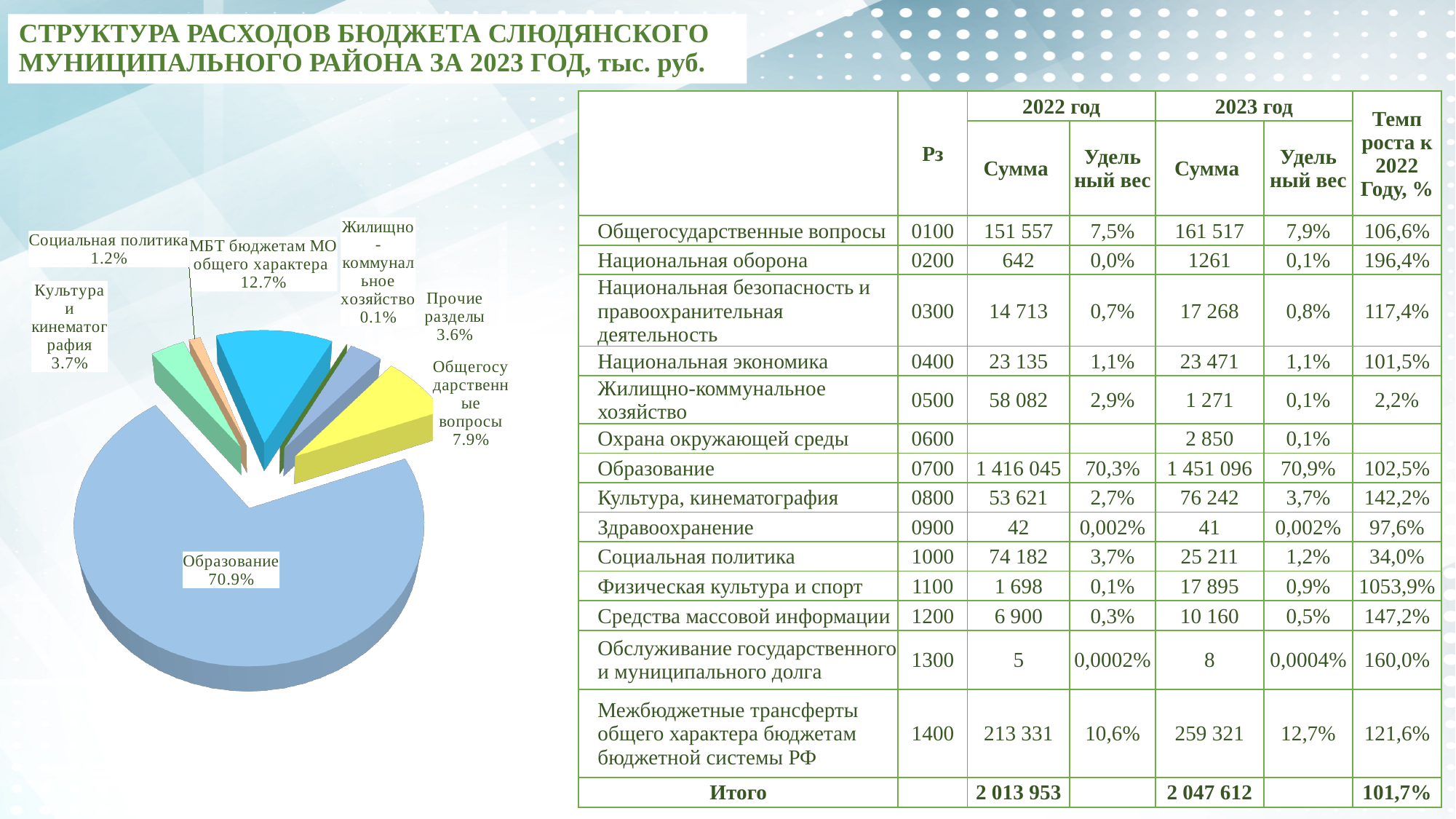
What colour is the Образование slice in the pie chart? light blue Which slice of the pie chart is the smallest? Жилищно-коммунальное хозяйство In the pie chart, what is the difference between the shares of МБТ бюджетам МО общего характера and Общегосударственные вопросы? 4.8% In the pie chart, what share does Образование have? 70.9% In the pie chart, which is larger: Прочие разделы or Социальная политика? Прочие разделы In the pie chart, what share does Жилищно-коммунальное хозяйство have? 0.1% In the pie chart, what share does МБТ бюджетам МО общего характера have? 12.7% What kind of chart is shown on the left of the slide? pie chart In the pie chart, what share does Общегосударственные вопросы have? 7.9% In the pie chart, what share does Культура и кинематография have? 3.7% Which slice of the pie chart is the largest? Образование How many slices does the pie chart have? 7